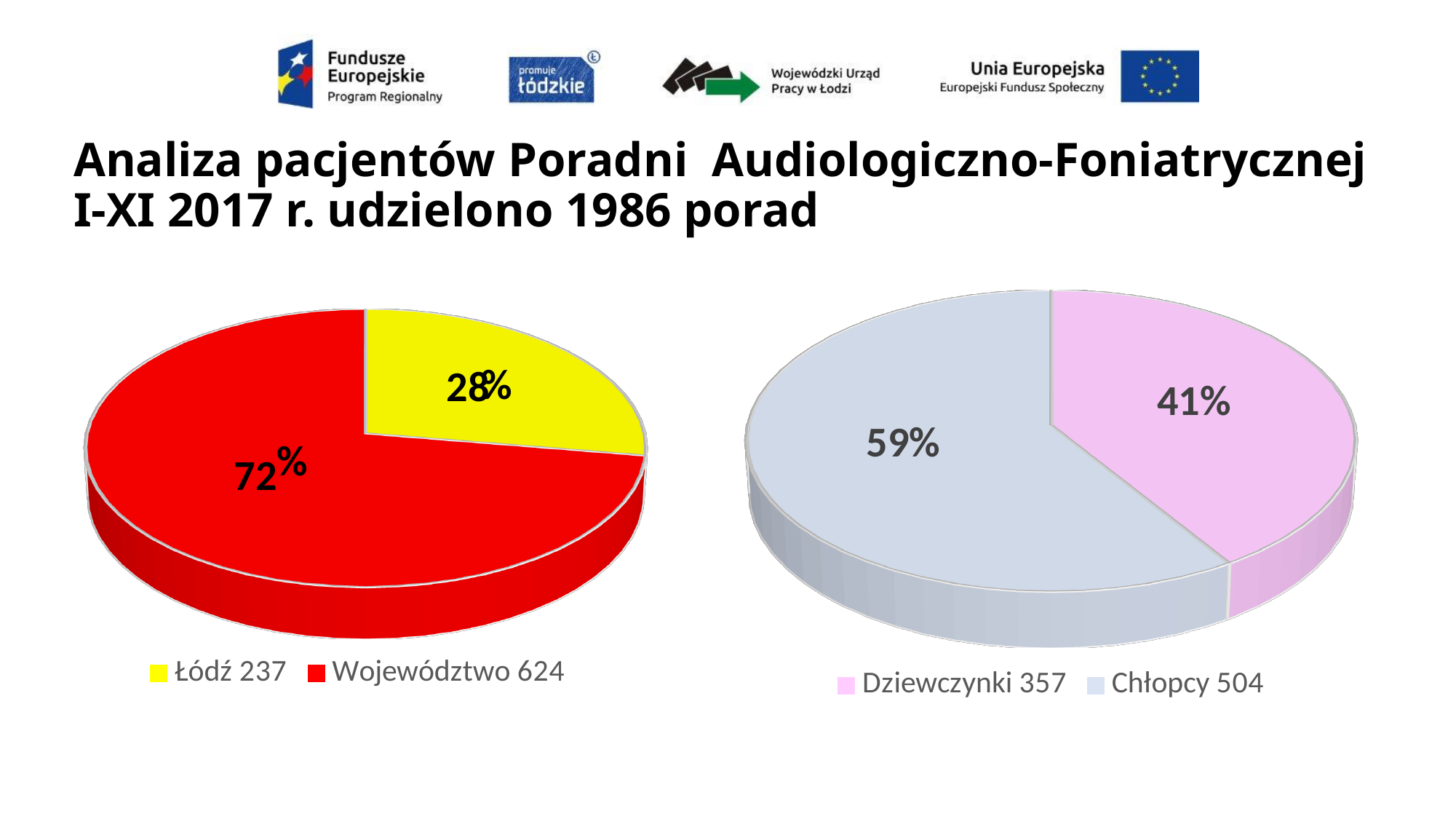
In the left pie chart, what percentage share does Województwo have? 72% In the right pie chart, what percentage share do Chłopcy have? 59% In the left pie chart, which category has the larger slice? Województwo In the left pie chart, what value is shown for Województwo in the legend? 624 What type of chart is the left chart on the slide? pie chart In the right pie chart, what is the difference between the Chłopcy value and the Dziewczynki value? 147 In the left pie chart, what is the difference between the Województwo value and the Łódź value? 387 In the left pie chart, what value is shown for Łódź in the legend? 237 In the right pie chart, what colour is the Dziewczynki slice? pink In the left pie chart, what percentage share does Łódź have? 28% In the right pie chart, what value is shown for Dziewczynki in the legend? 357 In the right pie chart, which category has the smaller slice? Dziewczynki